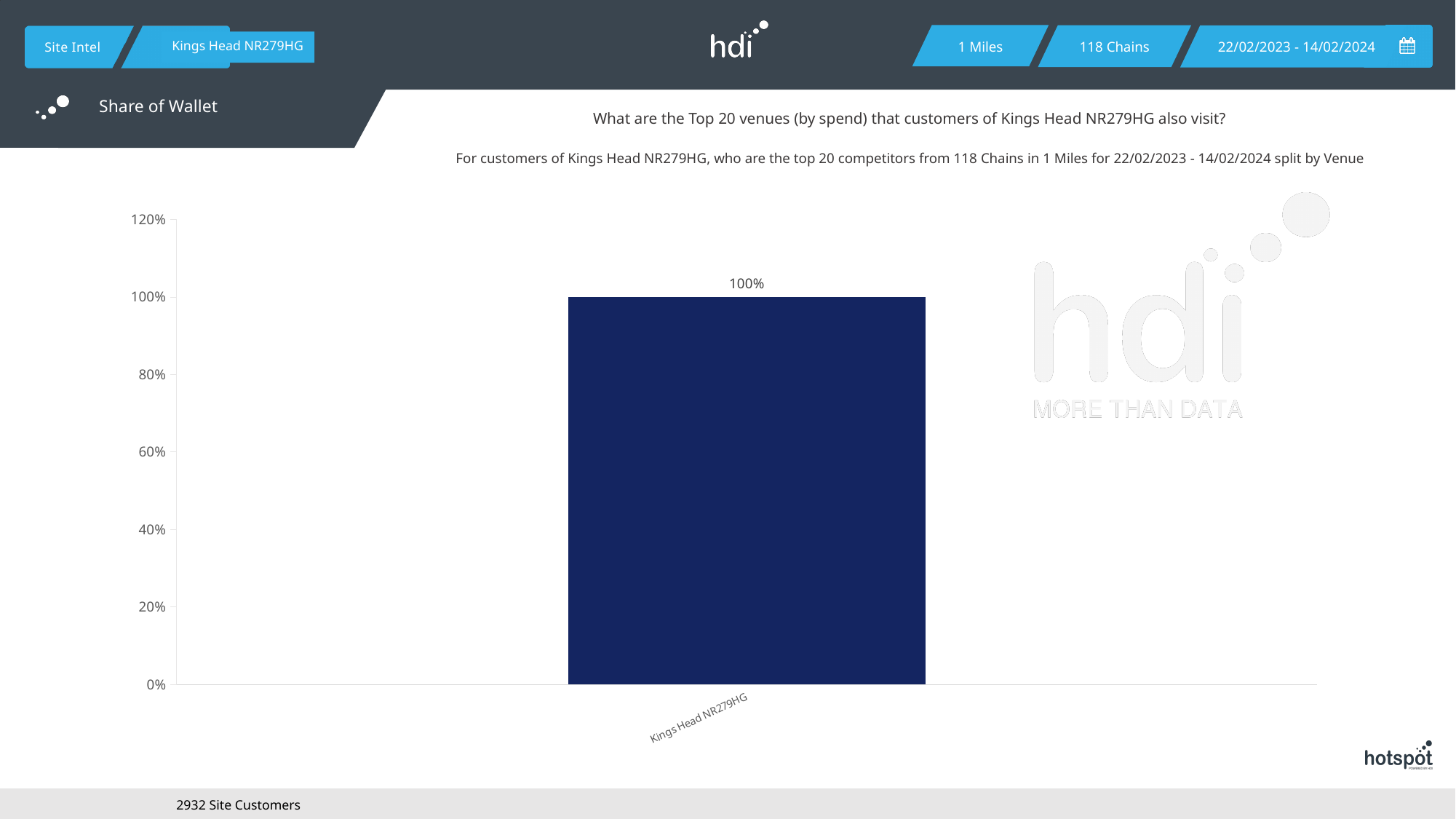
Which category has the highest value in the chart? Kings Head NR279HG How many bars are plotted in the chart? 1 Is the value for Kings Head NR279HG greater or less than 80%? greater What is the label of the only category on the x axis? Kings Head NR279HG What kind of chart is shown on the slide? bar chart Is the value for Kings Head NR279HG greater or less than 120%? less What is the value shown for Kings Head NR279HG? 100% What is the highest value shown on the vertical axis? 120%